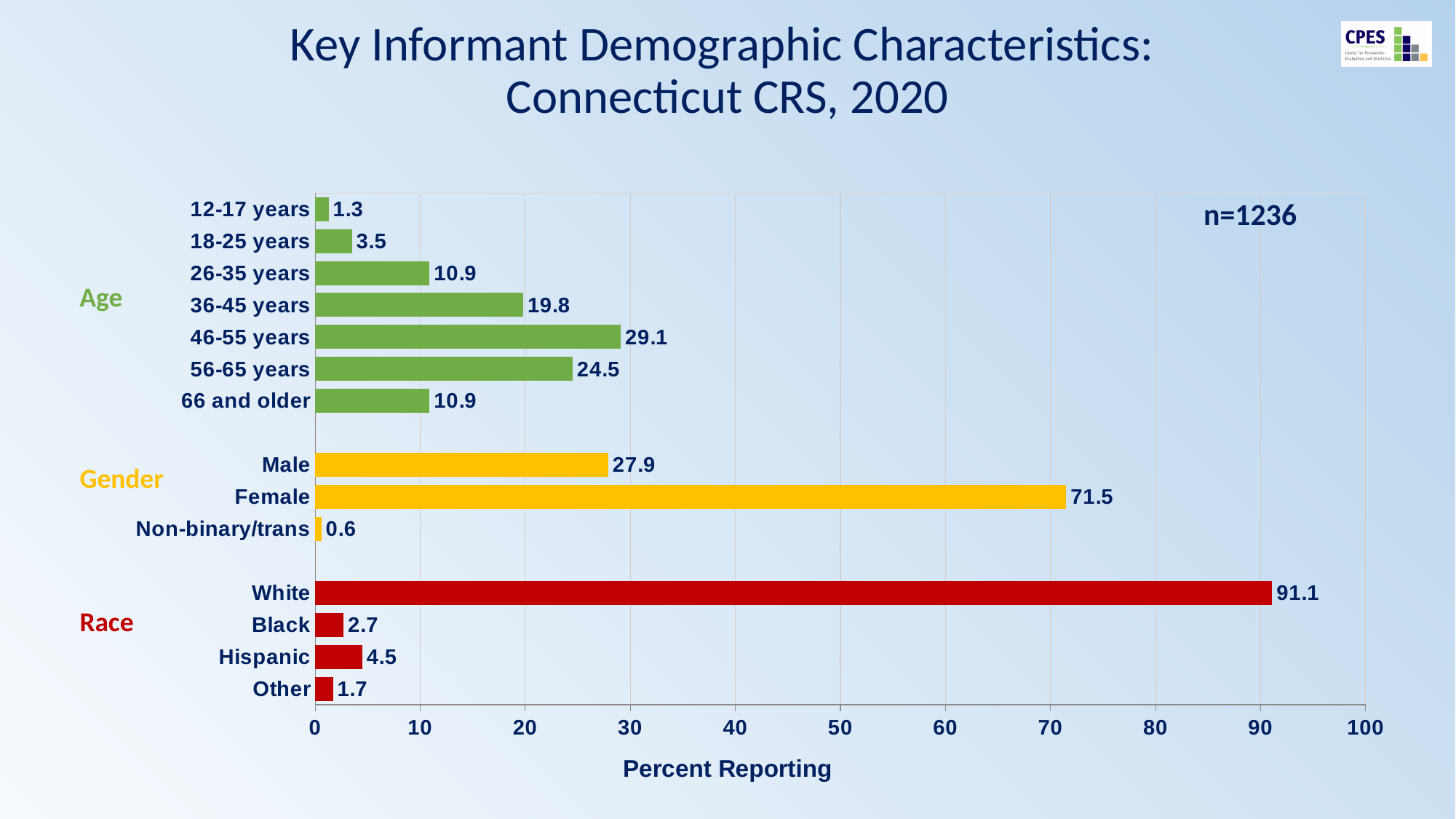
What is the value for the 46-55 years age group? 29.1 What is the value for Hispanic? 4.5 What is the label of the horizontal axis? Percent Reporting What is the difference between the values for Female and Male? 43.6 Which age group has the highest value? 46-55 years What is the value for Female? 71.5 What is the difference between the values for 46-55 years and 56-65 years? 4.6 What kind of chart is shown on the slide? Bar chart How many age group categories are shown on the chart? 7 Which is larger, the value for Male or the value for 46-55 years? 46-55 years Which category has the lowest value on the chart? Non-binary/trans Which category has the highest value on the chart? White